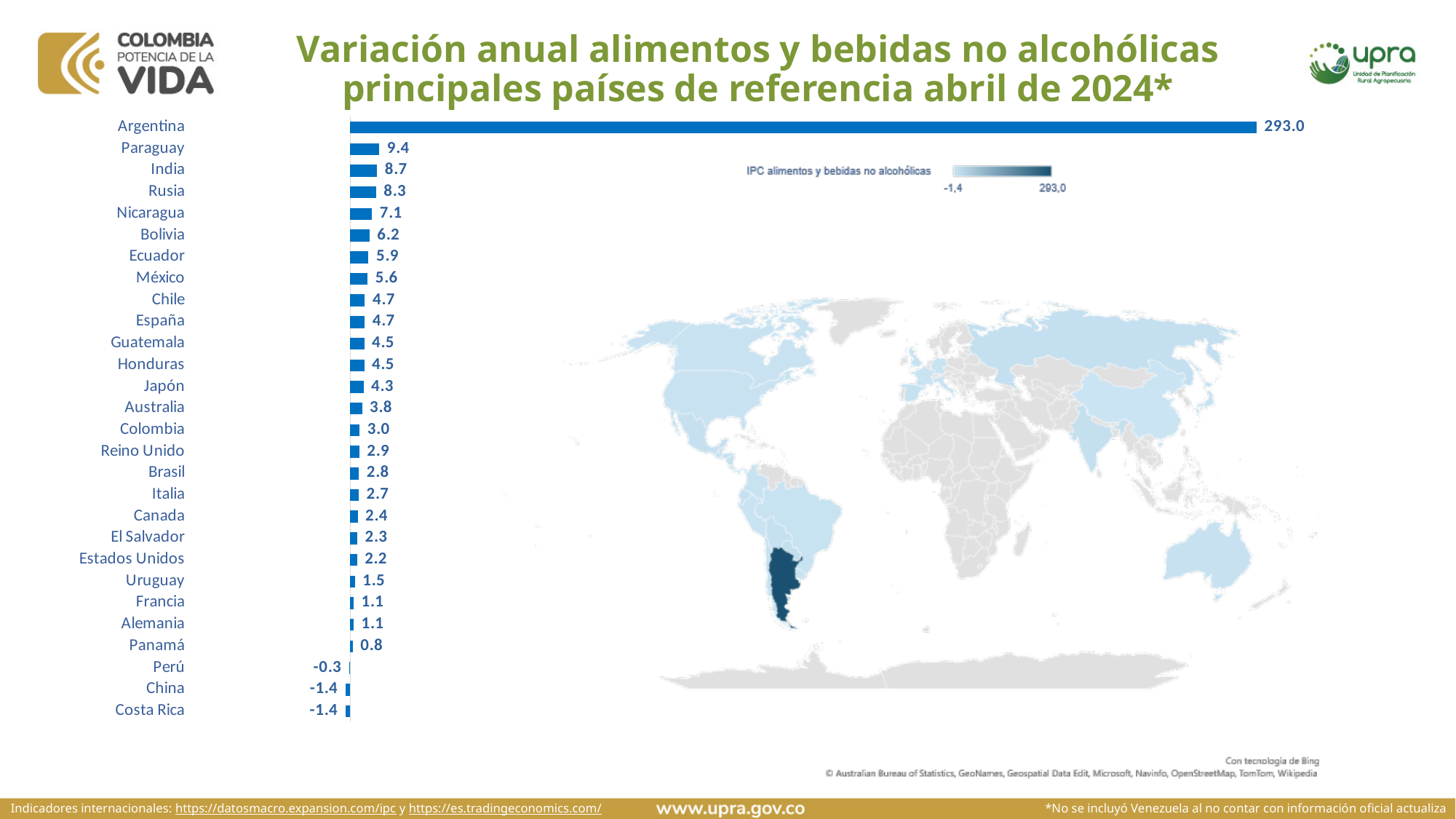
In the bar chart, what is the value for Colombia? 3.0 In the bar chart, what is the value for Argentina? 293.0 What kind of chart is used to show the values by country on the left of the slide? Bar chart In the bar chart, which has a larger value, Rusia or Nicaragua? Rusia How many countries are shown in the bar chart? 28 What is the title of the slide's chart? Variación anual alimentos y bebidas no alcohólicas principales países de referencia abril de 2024* In the bar chart, what is the difference between the values for Paraguay and India? 0.7 In the bar chart, what is the value for Perú? -0.3 In the bar chart, what is the difference between the values for Argentina and Paraguay? 283.6 In the bar chart, which country has the highest value? Argentina In the bar chart, which has a larger value, Chile or Brasil? Chile In the bar chart, what is the value for Estados Unidos? 2.2